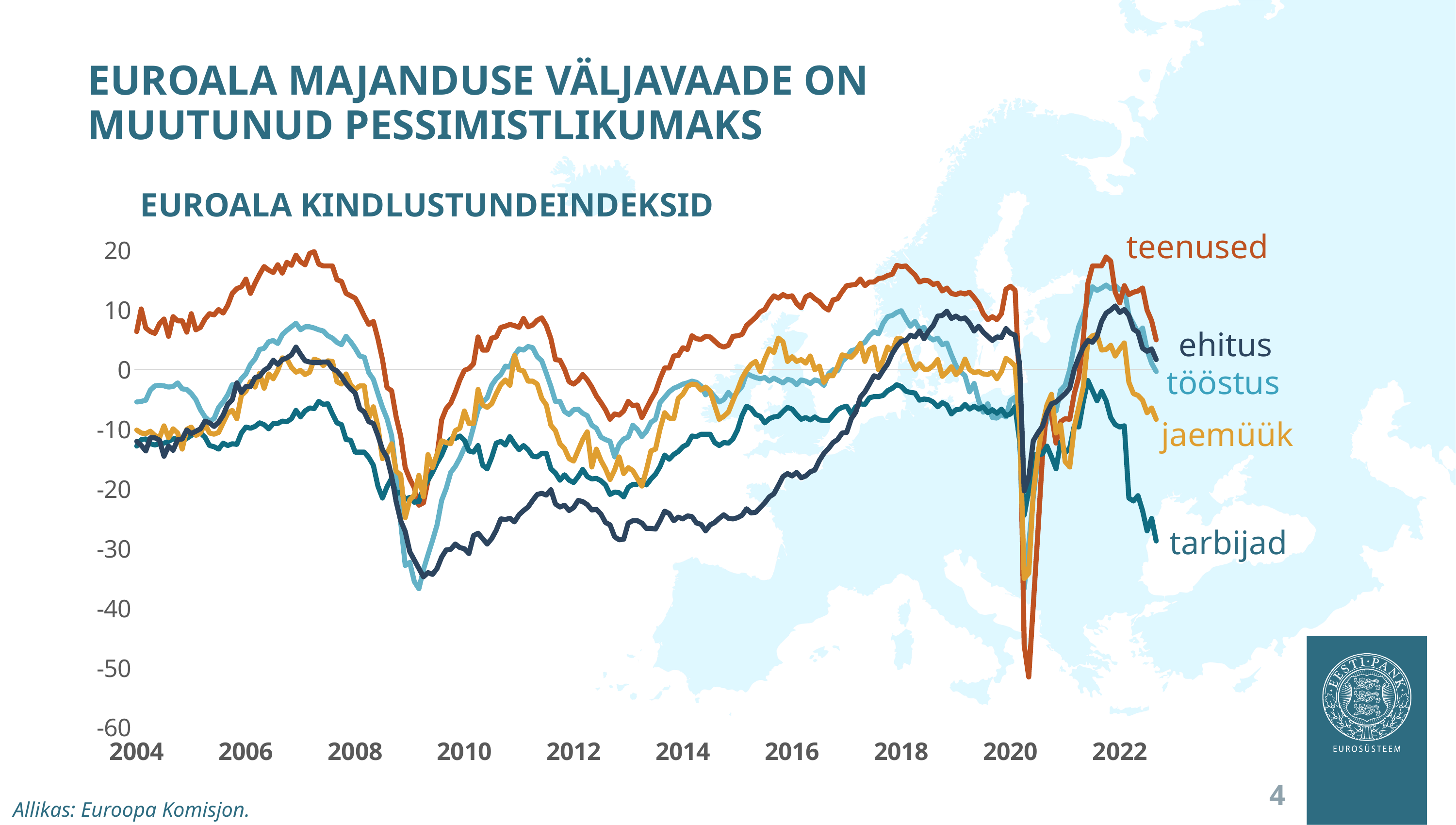
Which series has the highest value at the end of the chart in 2022? teenused Which series has the lowest value at the end of the chart in 2022? tarbijad At the end of 2022, which is larger: teenused or tarbijad? teenused What kind of chart is shown on the slide? line chart Is the value for teenused at the end of 2022 greater or less than 0? greater How many series are plotted in the chart? 5 Is the value for tarbijad at the end of 2022 greater or less than -20? less Is the lowest value of teenused in 2020 greater or less than -40? less Which series drops to the lowest value in 2020? teenused What is the title of the chart? EUROALA KINDLUSTUNDEINDEKSID What source is cited for the chart? Euroopa Komisjon Does the tarbijad series rise or fall from 2021 to the end of 2022? fall